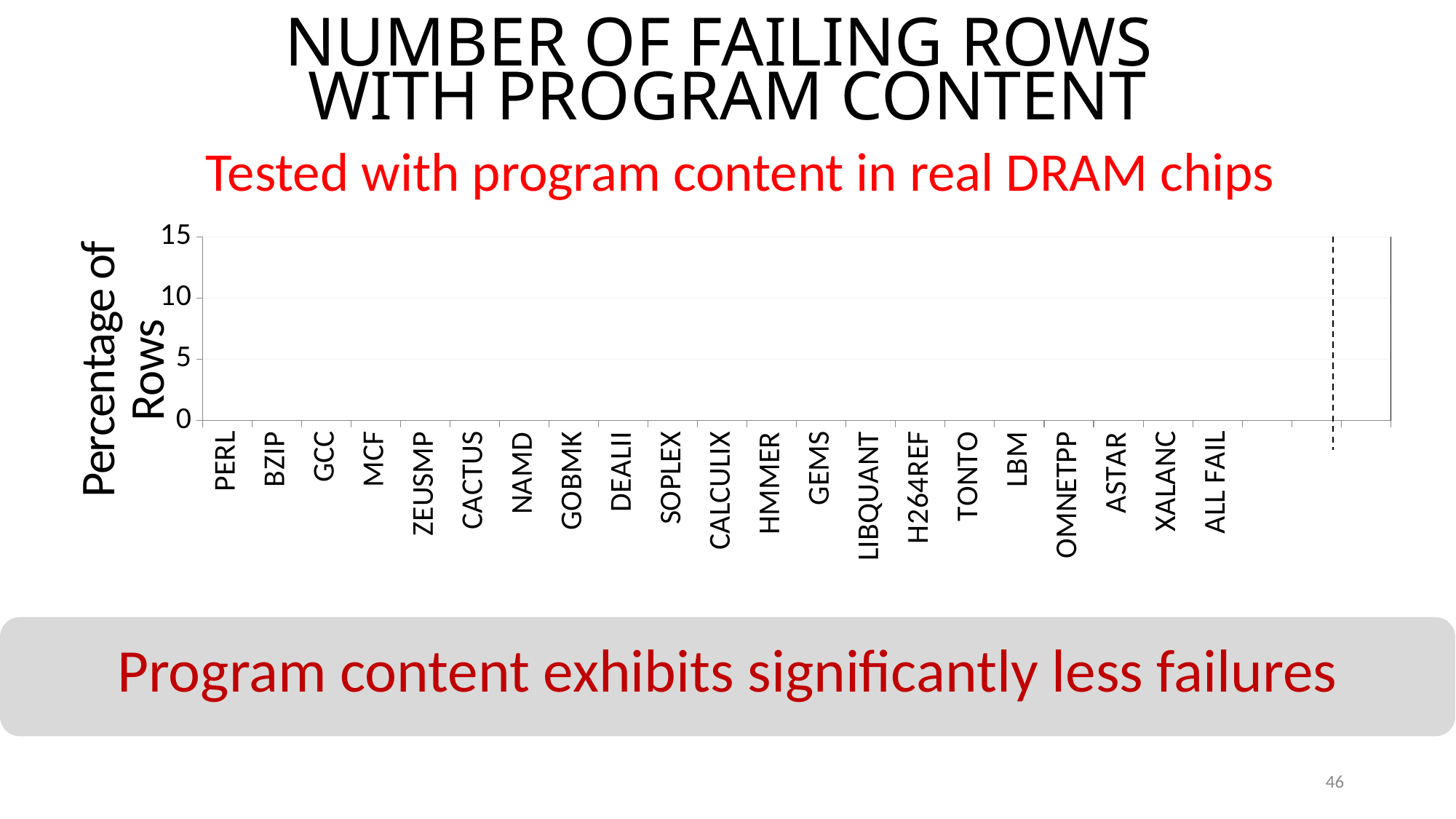
How many categories are labelled on the x axis of the chart? 21 What is the last category labelled on the x axis of the chart? ALL FAIL What is the highest tick value shown on the vertical axis of the chart? 15 What is the label of the vertical axis of the chart? Percentage of Rows What is the first category labelled on the x axis of the chart? PERL